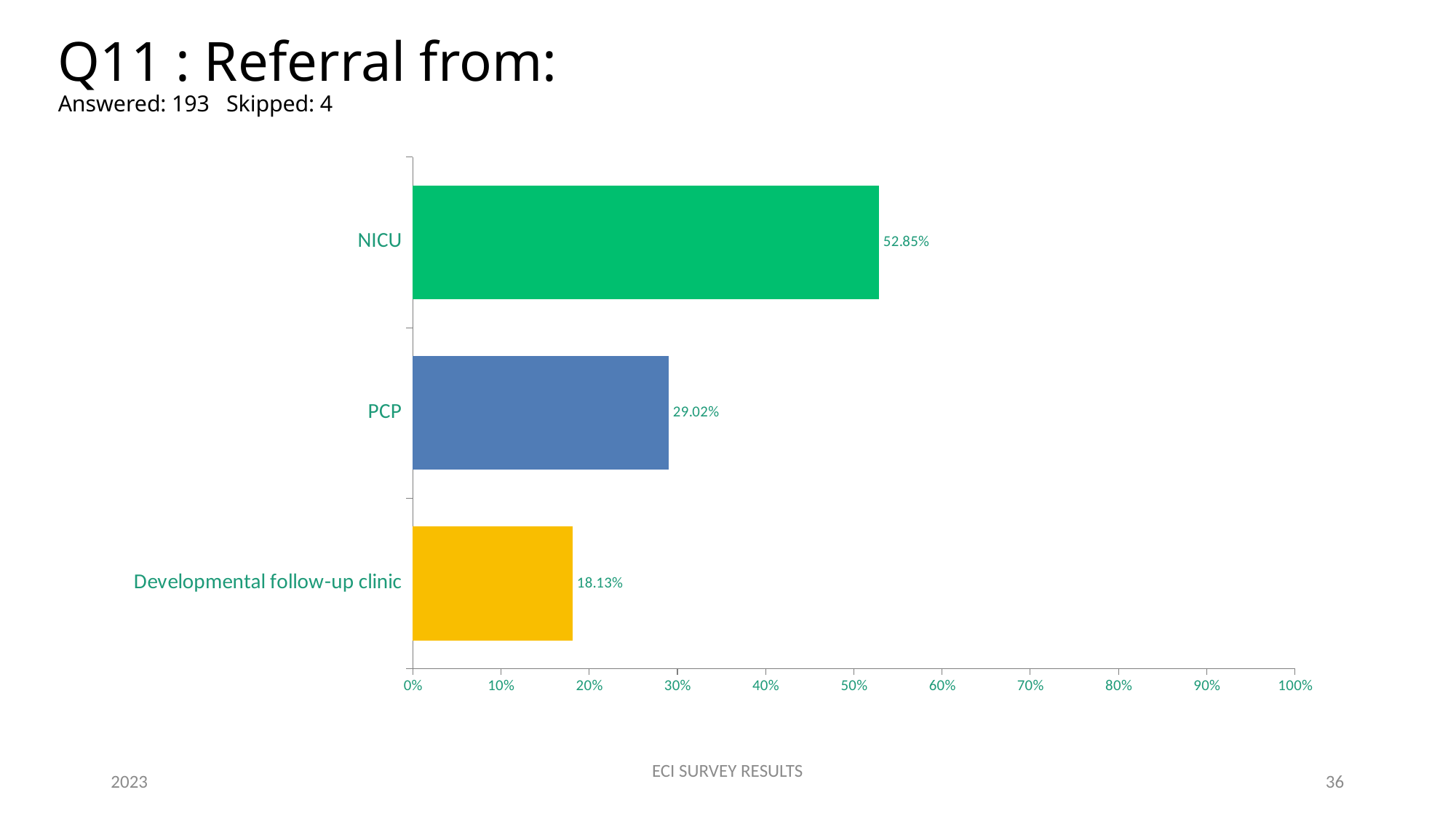
What percentage of referrals came from NICU? 52.85% What percentage of referrals came from Developmental follow-up clinic? 18.13% What is the difference in percentage points between PCP and Developmental follow-up clinic referrals? 10.89 Which is larger, the value for PCP or the value for Developmental follow-up clinic? PCP What percentage of referrals came from PCP? 29.02% How many referral source categories are shown in the chart? 3 What kind of chart is shown on the slide? Bar chart Which referral source has the highest percentage? NICU Is the value for NICU greater or less than 50%? greater What is the difference in percentage points between NICU and PCP referrals? 23.83 How many respondents answered this question according to the slide? 193 Which referral source has the lowest percentage? Developmental follow-up clinic